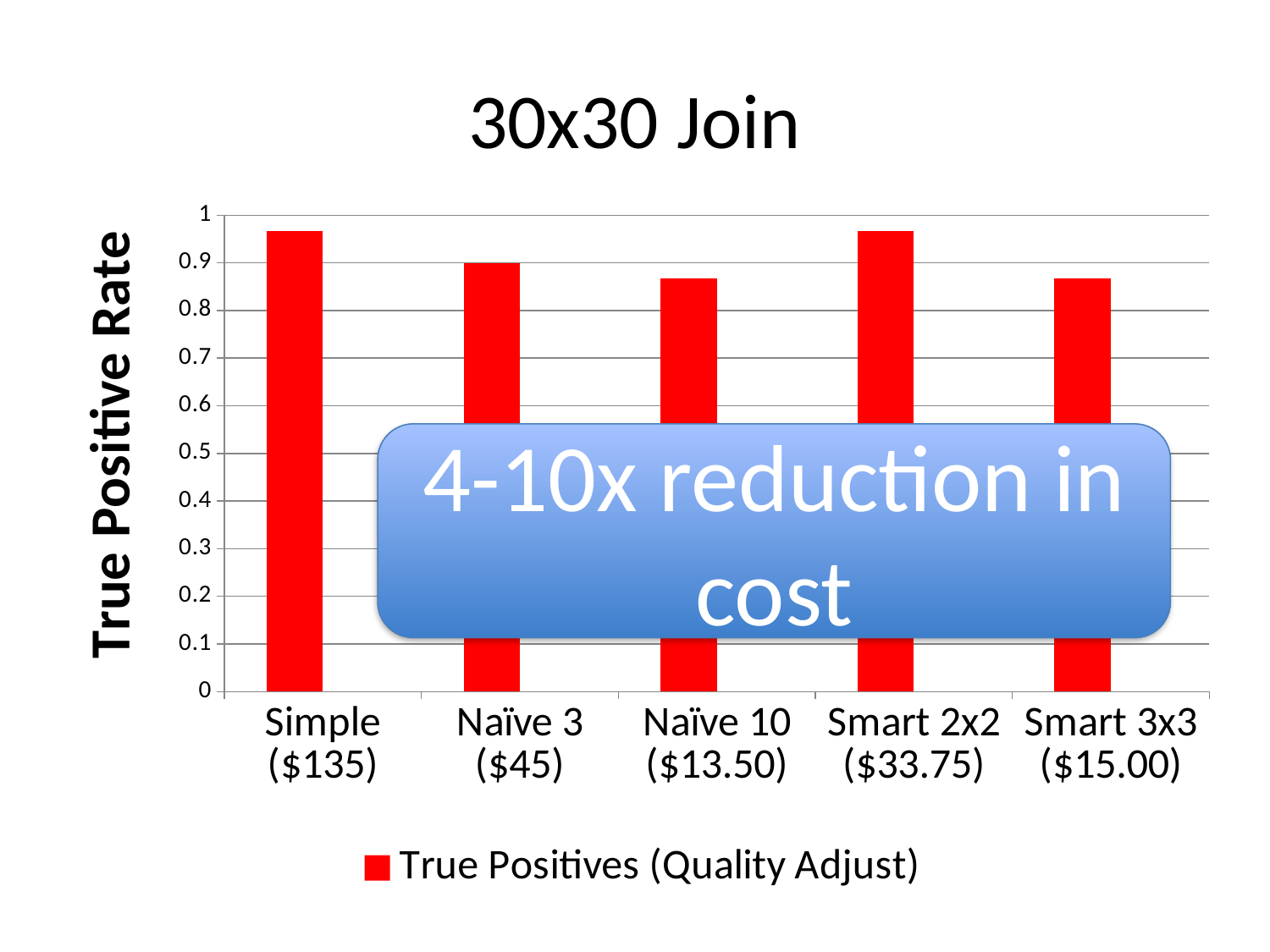
What kind of chart is shown on the slide? bar chart How many series does the legend list? 1 Is the value for Naïve 10 ($13.50) greater or less than 0.9? less What is the title of the chart? 30x30 Join What is the label of the series in the legend? True Positives (Quality Adjust) How many categories are shown on the x axis of the chart? 5 Which has a higher true positive rate, Smart 2x2 ($33.75) or Naïve 3 ($45)? Smart 2x2 ($33.75) Is the value for Smart 3x3 ($15.00) greater or less than 0.8? greater Is the value for Simple ($135) greater or less than 0.9? greater Which has a higher true positive rate, Simple ($135) or Naïve 10 ($13.50)? Simple ($135) Which has a higher true positive rate, Naïve 3 ($45) or Smart 3x3 ($15.00)? Naïve 3 ($45)